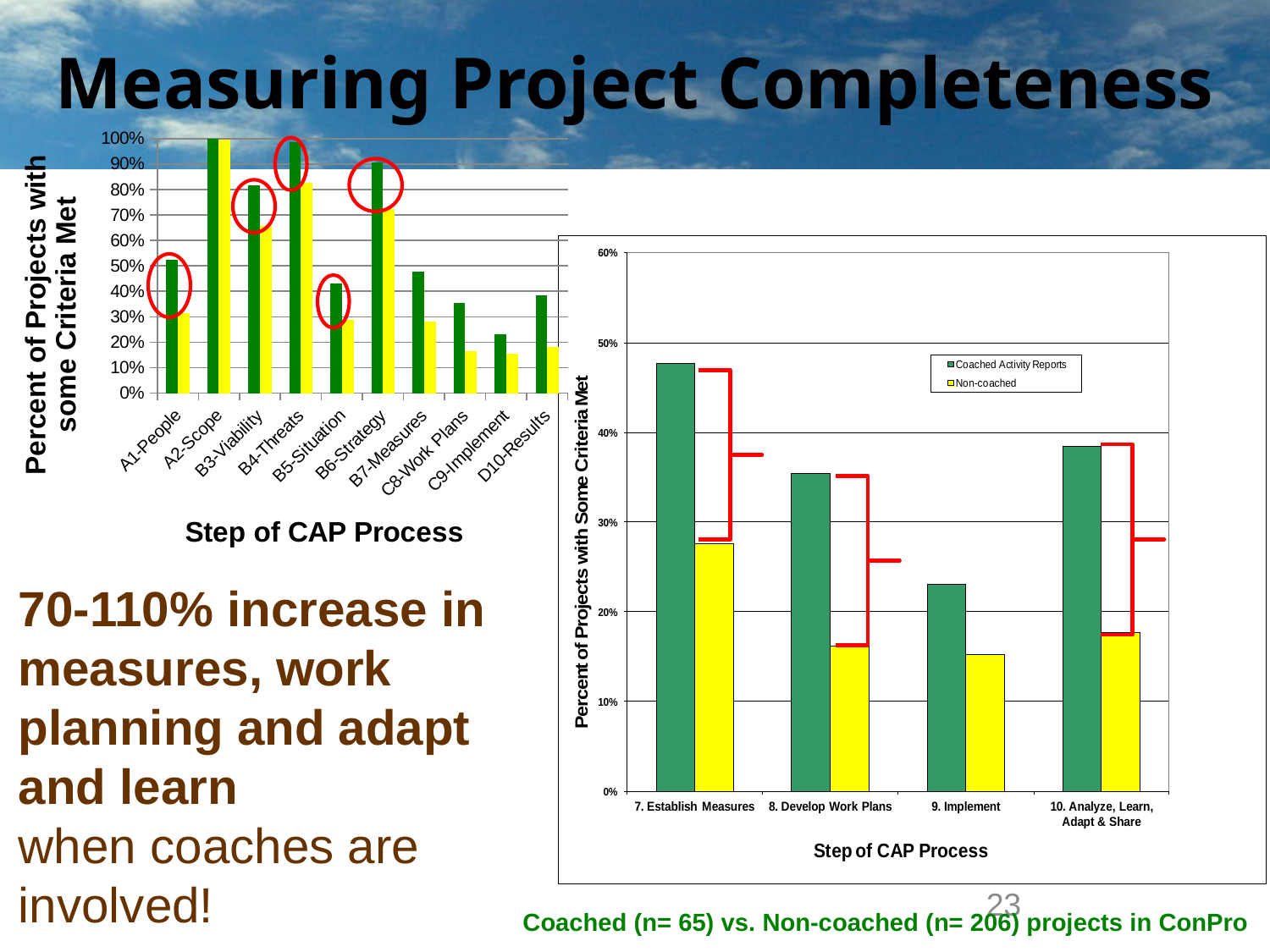
In the left-hand chart, is the green bar for B6-Strategy greater or less than 80%? greater How many series does the legend of the right-hand chart list? 2 In the left-hand chart, which step has the highest green bar? A2-Scope What kind of chart is the chart on the right of the slide? Bar chart In the right-hand chart, is the Non-coached value for 8. Develop Work Plans greater or less than 20%? less In the right-hand chart, which series has the larger value for 9. Implement, Coached Activity Reports or Non-coached? Coached Activity Reports How many steps of the CAP process are shown on the x axis of the left-hand chart? 10 In the right-hand chart, is the Coached Activity Reports value for 7. Establish Measures greater or less than 40%? greater In the right-hand chart, which step has the highest value for Coached Activity Reports? 7. Establish Measures What are the two series named in the legend of the right-hand chart? Coached Activity Reports and Non-coached How many steps of the CAP process are shown on the x axis of the right-hand chart? 4 In the right-hand chart, which step has the lowest value for Coached Activity Reports? 9. Implement